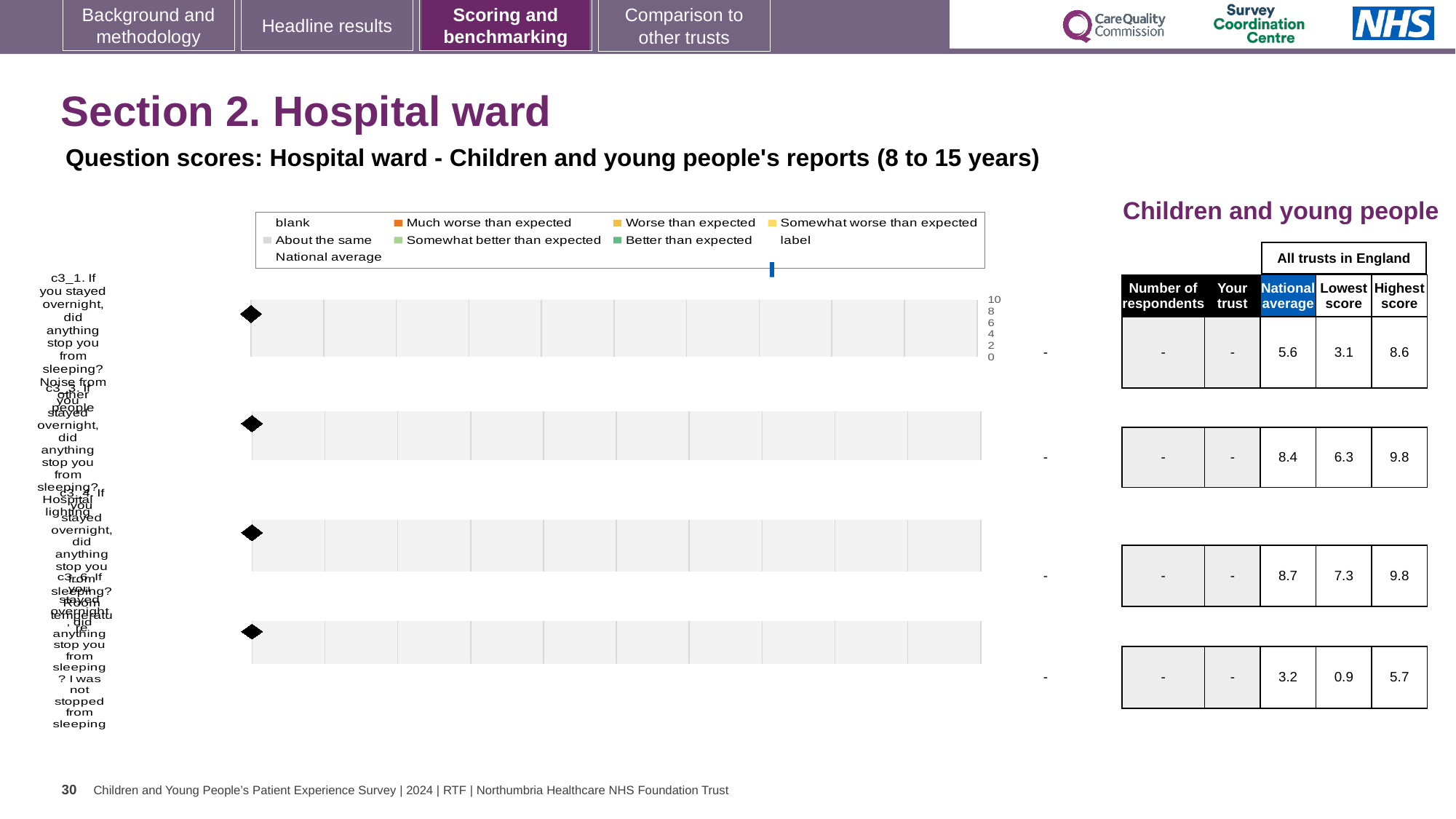
What colour does the legend use for 'Much worse than expected'? orange What is the highest value shown on the chart's axis? 10 In the table on the right, what is the National average for the first question row? 5.6 In the table on the right, what is the Highest score for the second question row? 9.8 In the table on the right, which question row has the lowest National average? the fourth row (3.2) In the table on the right, what is the difference between the Highest score and Lowest score for the first question row? 5.5 What kind of chart is shown on the slide? bar chart In the table on the right, what is the Lowest score for the fourth question row? 0.9 In the table on the right, which question row has the highest National average? the third row (8.7) In the table on the right, is the National average for the third question row larger than that for the second question row? yes, 8.7 vs 8.4 How many question rows (categories) does the chart have? 4